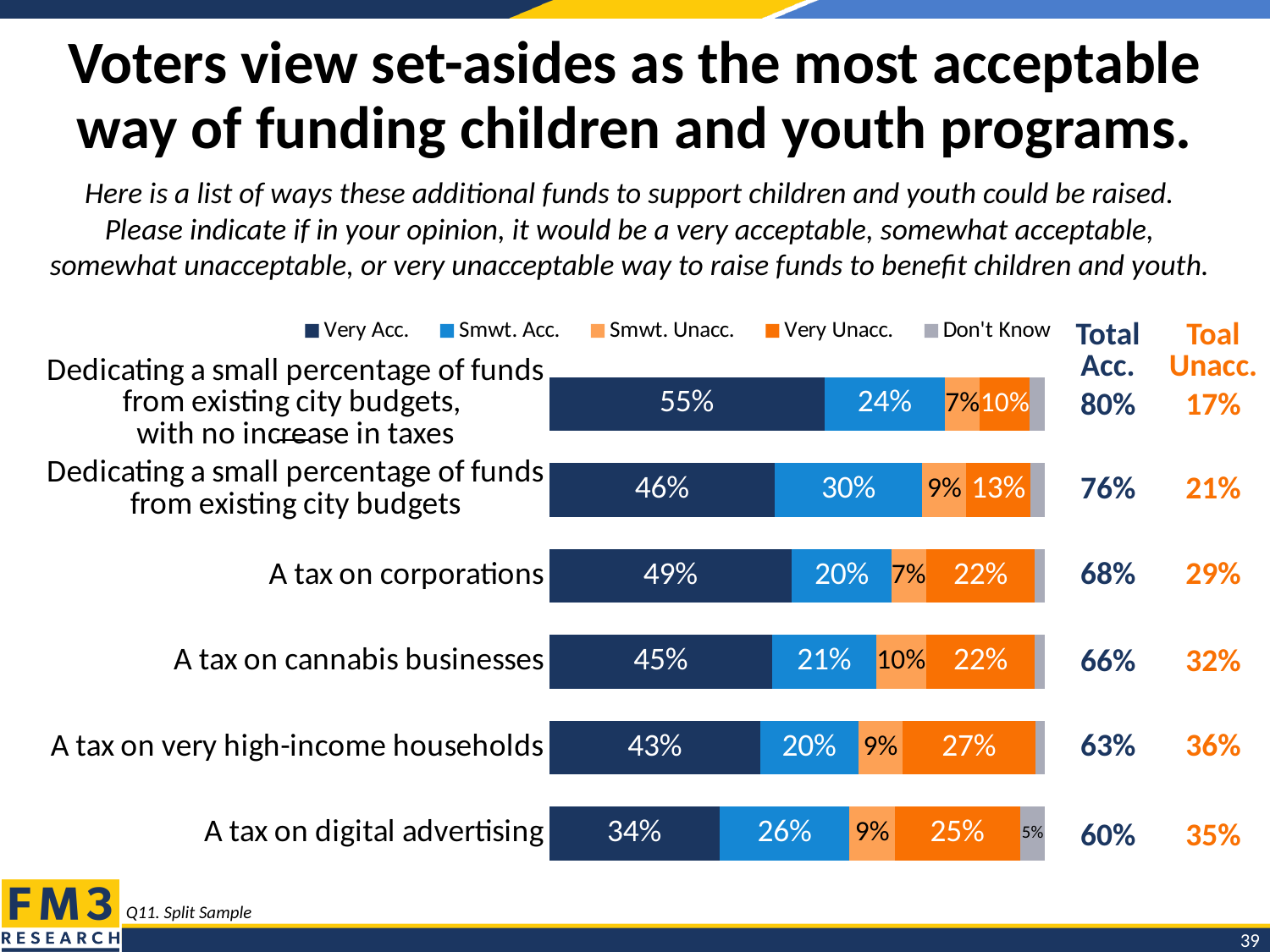
How many funding options (categories) are plotted in the chart? 6 Which category has the lowest "Very Acc." value? A tax on digital advertising What is the "Very Acc." value for "A tax on corporations"? 49% Which is larger: the "Very Unacc." value for "A tax on very high-income households" or for "A tax on digital advertising"? A tax on very high-income households How many series does the legend list? 5 What kind of chart is shown on the slide? Stacked bar chart Which category has the highest "Very Acc." value? Dedicating a small percentage of funds from existing city budgets, with no increase in taxes What is the "Smwt. Acc." value for "Dedicating a small percentage of funds from existing city budgets"? 30% What is the "Total Acc." figure shown for "A tax on cannabis businesses"? 66% What is the "Very Unacc." value for "A tax on very high-income households"? 27% What is the "Don't Know" value for "A tax on digital advertising"? 5% What is the difference between the "Very Acc." values for "A tax on corporations" and "A tax on cannabis businesses"? 4%